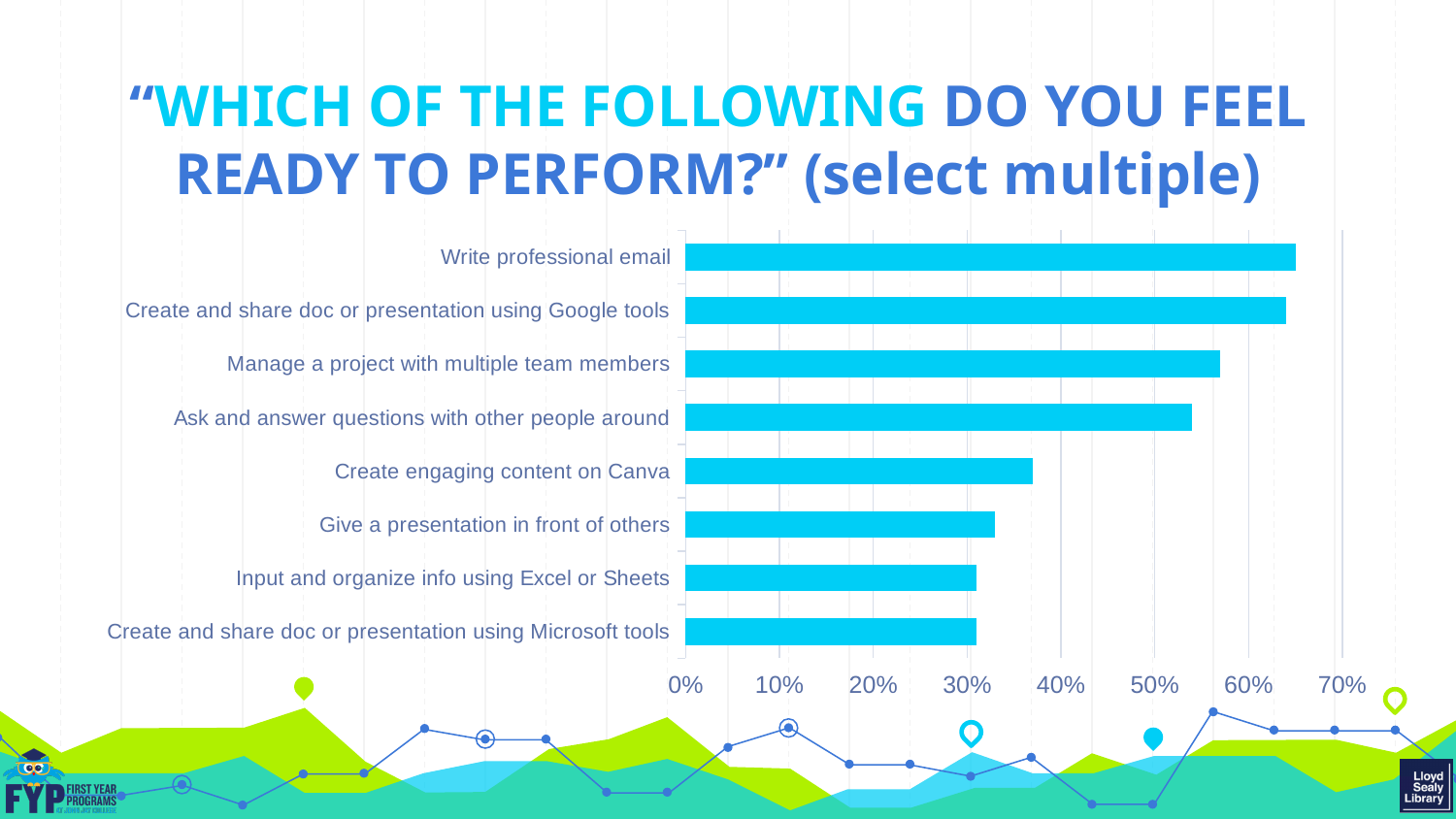
Is the value for "Manage a project with multiple team members" greater or less than 50%? greater Is the value for "Create and share doc or presentation using Google tools" greater or less than 60%? greater What kind of chart is shown on the slide? bar chart Which has the larger value: "Write professional email" or "Create and share doc or presentation using Microsoft tools"? Write professional email How many categories (skills) are plotted in the chart? 8 Which has the larger value: "Manage a project with multiple team members" or "Create engaging content on Canva"? Manage a project with multiple team members Is the value for "Create and share doc or presentation using Microsoft tools" greater or less than 40%? less What is the highest percentage tick shown on the chart's axis? 70%